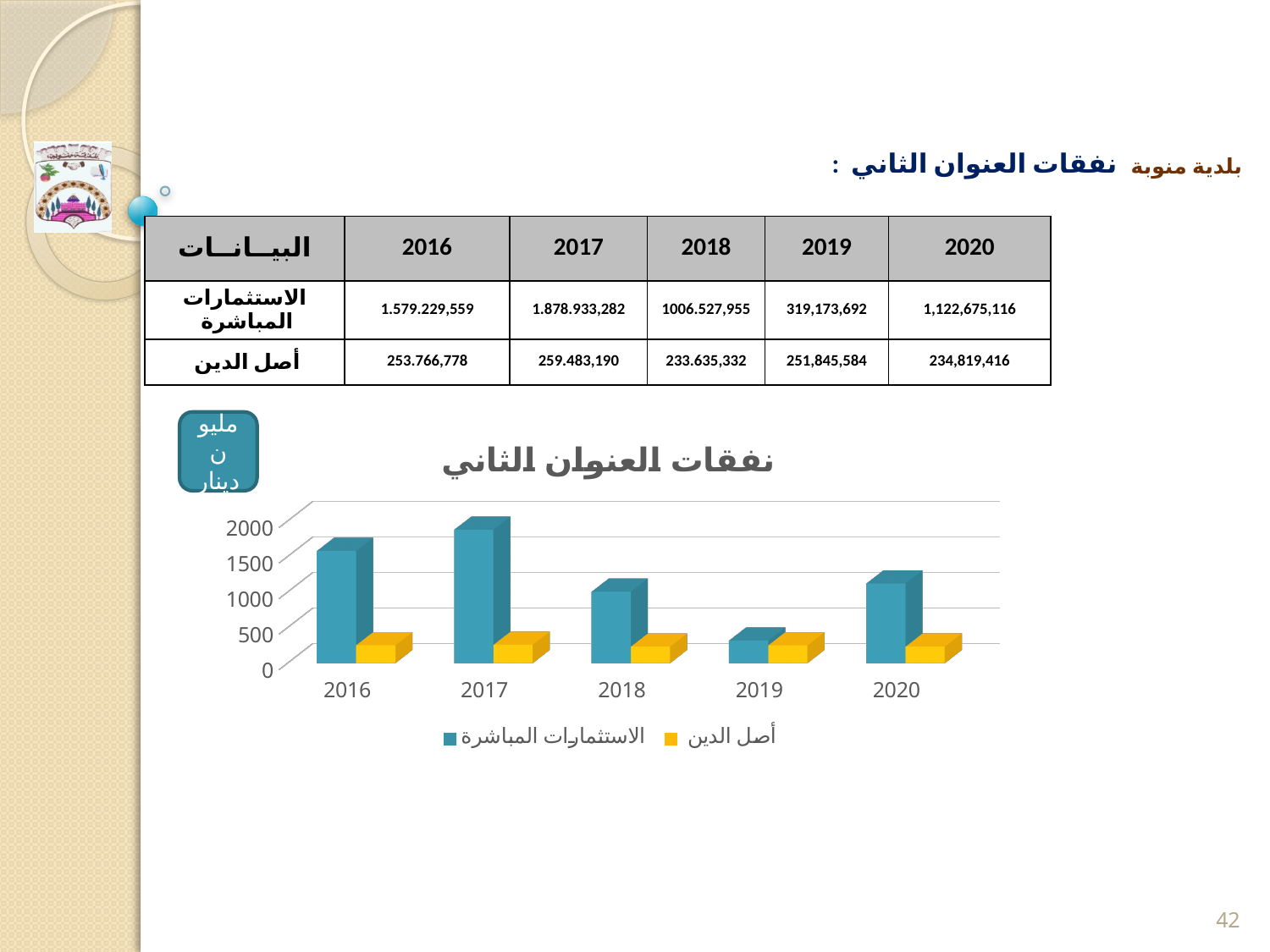
Which year has the highest value for الاستثمارات المباشرة in the chart? 2017 What is the title of the chart? نفقات العنوان الثاني Which is larger in the chart: الاستثمارات المباشرة in 2017 or in 2016? 2017 Is the value for الاستثمارات المباشرة in 2017 greater or less than 1500? greater How many years are shown on the x axis of the chart? 5 Is the value for أصل الدين in 2016 greater or less than 500? less Which is larger in the chart: الاستثمارات المباشرة in 2019 or in 2020? 2020 Is the value for الاستثمارات المباشرة in 2019 greater or less than 500? less What kind of chart is shown on the slide? bar chart Which year has the lowest value for الاستثمارات المباشرة in the chart? 2019 Do the values for الاستثمارات المباشرة rise or fall from 2017 to 2019? fall How many series does the chart legend list? 2